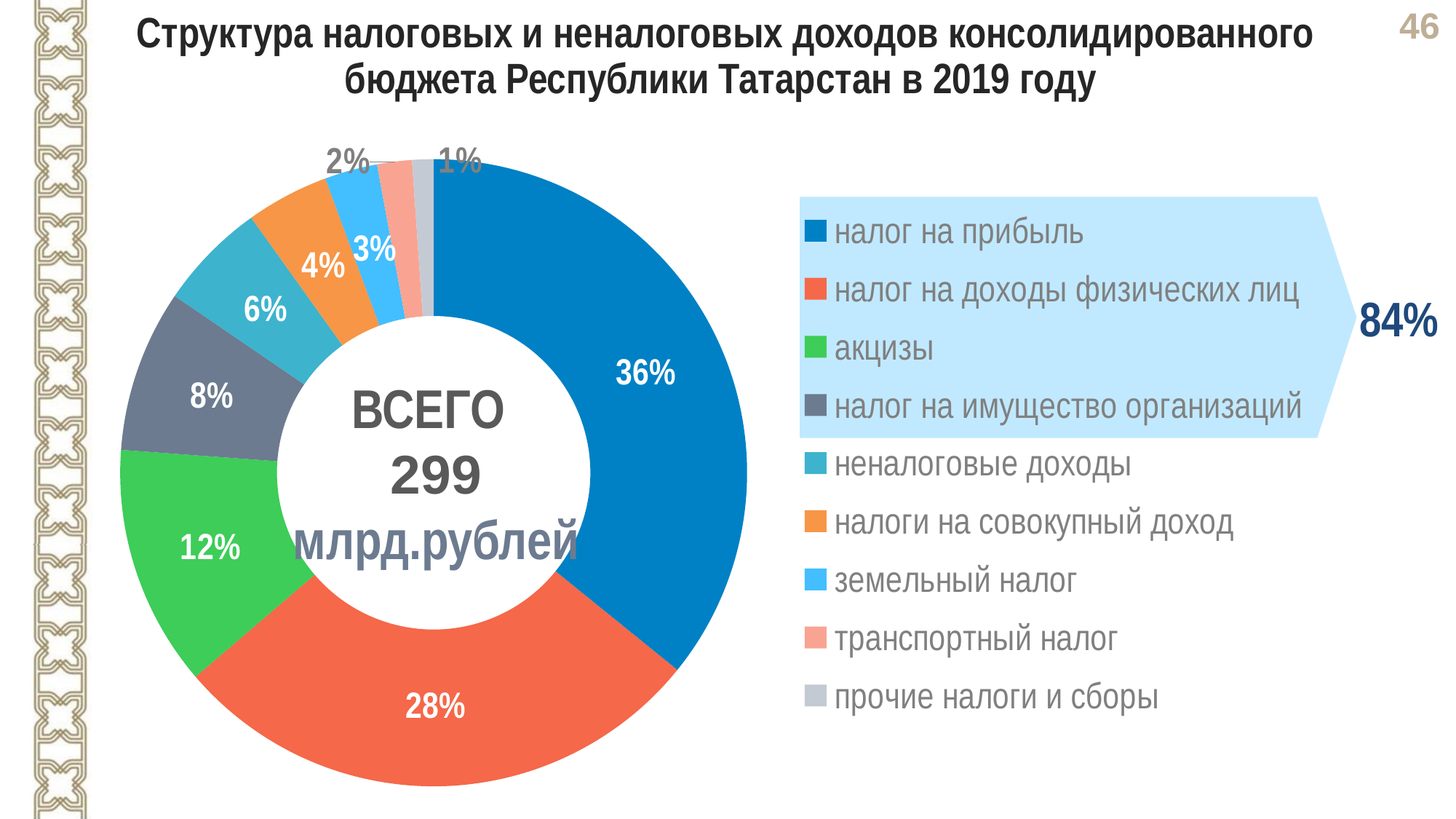
What share of the donut chart does налог на доходы физических лиц account for? 28% How many categories does the legend of the donut chart list? 9 What share of the donut chart does налог на прибыль account for? 36% What is the value shown for неналоговые доходы? 6% What total amount is written in the centre of the donut chart? 299 млрд.рублей Which category has the smallest slice of the donut chart? прочие налоги и сборы What is the value shown for акцизы? 12% Which category has the largest slice of the donut chart? налог на прибыль What is the difference in percentage points between налог на прибыль and налог на доходы физических лиц? 8 Which is larger, the share for акцизы or the share for налог на имущество организаций? акцизы What is the value shown for налог на имущество организаций? 8% What kind of chart is shown on the slide? donut (pie) chart